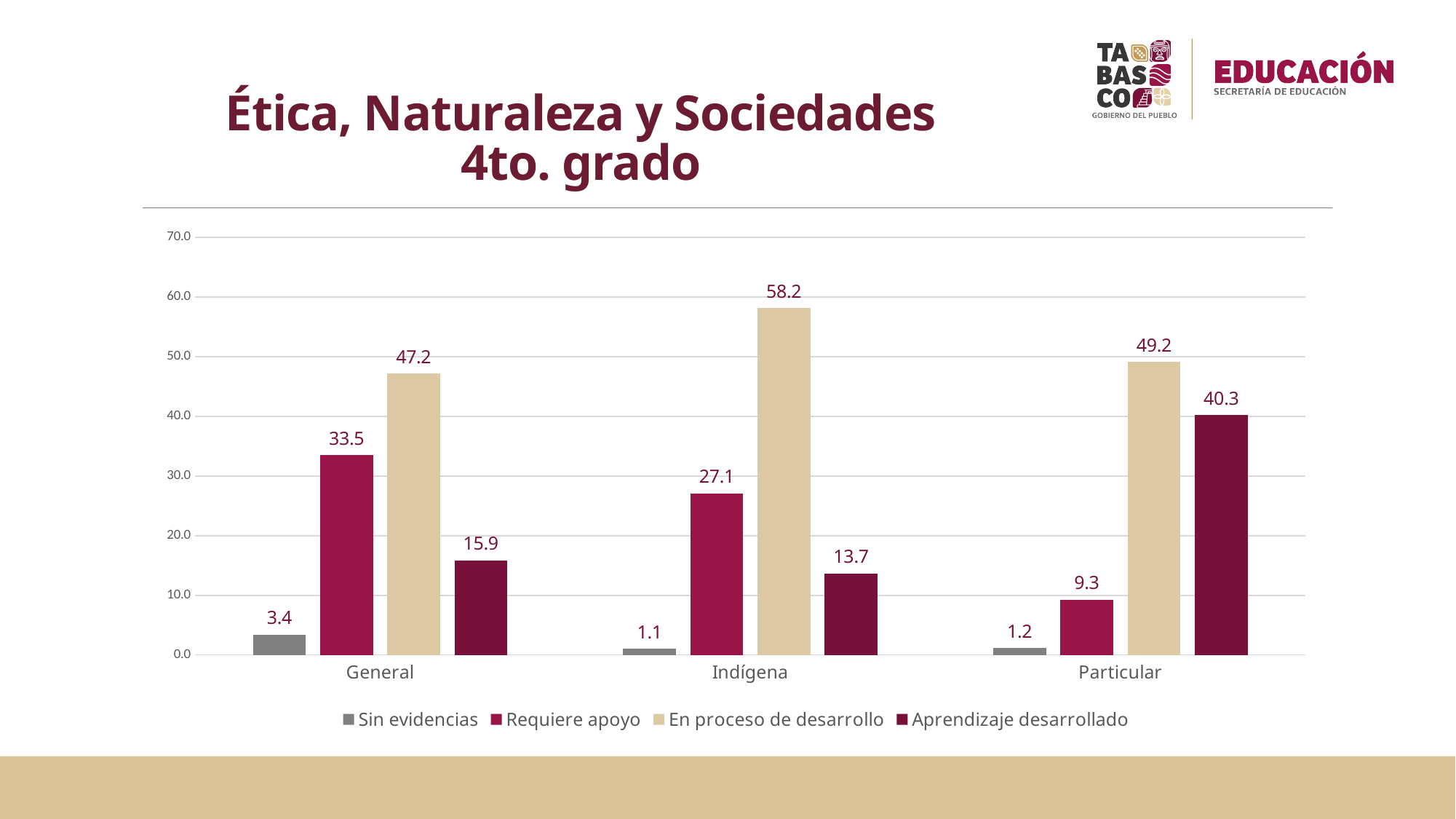
What is the difference between 'En proceso de desarrollo' and 'Aprendizaje desarrollado' in the Particular category? 8.9 What is the value for 'Aprendizaje desarrollado' in the Particular category? 40.3 Which category has the highest value for 'Requiere apoyo'? General Which category has the lowest value for 'Sin evidencias'? Indígena What is the value for 'Sin evidencias' in the General category? 3.4 What is the value for 'En proceso de desarrollo' in the Indígena category? 58.2 What is the title of the slide? Ética, Naturaleza y Sociedades 4to. grado How many series does the legend list? 4 How many categories are shown on the x axis? 3 Is the value for 'Aprendizaje desarrollado' in the General category greater or less than 20.0? less Which is larger: 'Requiere apoyo' for General or 'Requiere apoyo' for Indígena? General What kind of chart is shown on the slide? bar chart